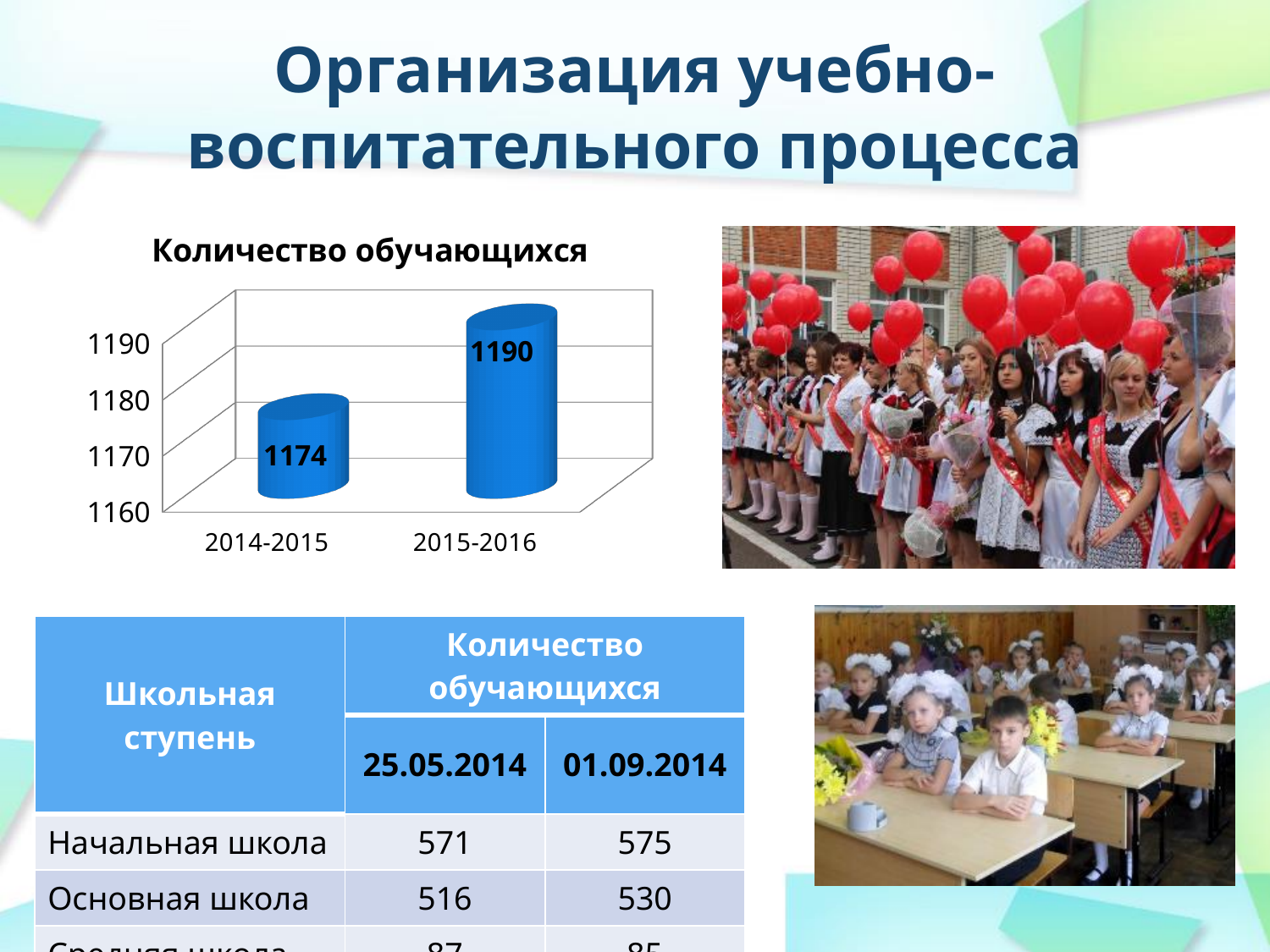
Do the values in the chart 'Количество обучающихся' rise or fall from 2014-2015 to 2015-2016? rise How many categories are shown in the chart 'Количество обучающихся'? 2 What colour are the bars in the chart 'Количество обучающихся'? blue In the chart 'Количество обучающихся', which is larger: the value for 2014-2015 or for 2015-2016? 2015-2016 Is the value for 2014-2015 in the chart 'Количество обучающихся' greater or less than 1180? less What is the title of the chart on the slide? Количество обучающихся Which category has the highest value in the chart 'Количество обучающихся'? 2015-2016 What is the value for 2015-2016 in the chart 'Количество обучающихся'? 1190 Which category has the lowest value in the chart 'Количество обучающихся'? 2014-2015 What is the difference between the values for 2015-2016 and 2014-2015 in the chart 'Количество обучающихся'? 16 What is the value for 2014-2015 in the chart 'Количество обучающихся'? 1174 What kind of chart is 'Количество обучающихся'? bar chart